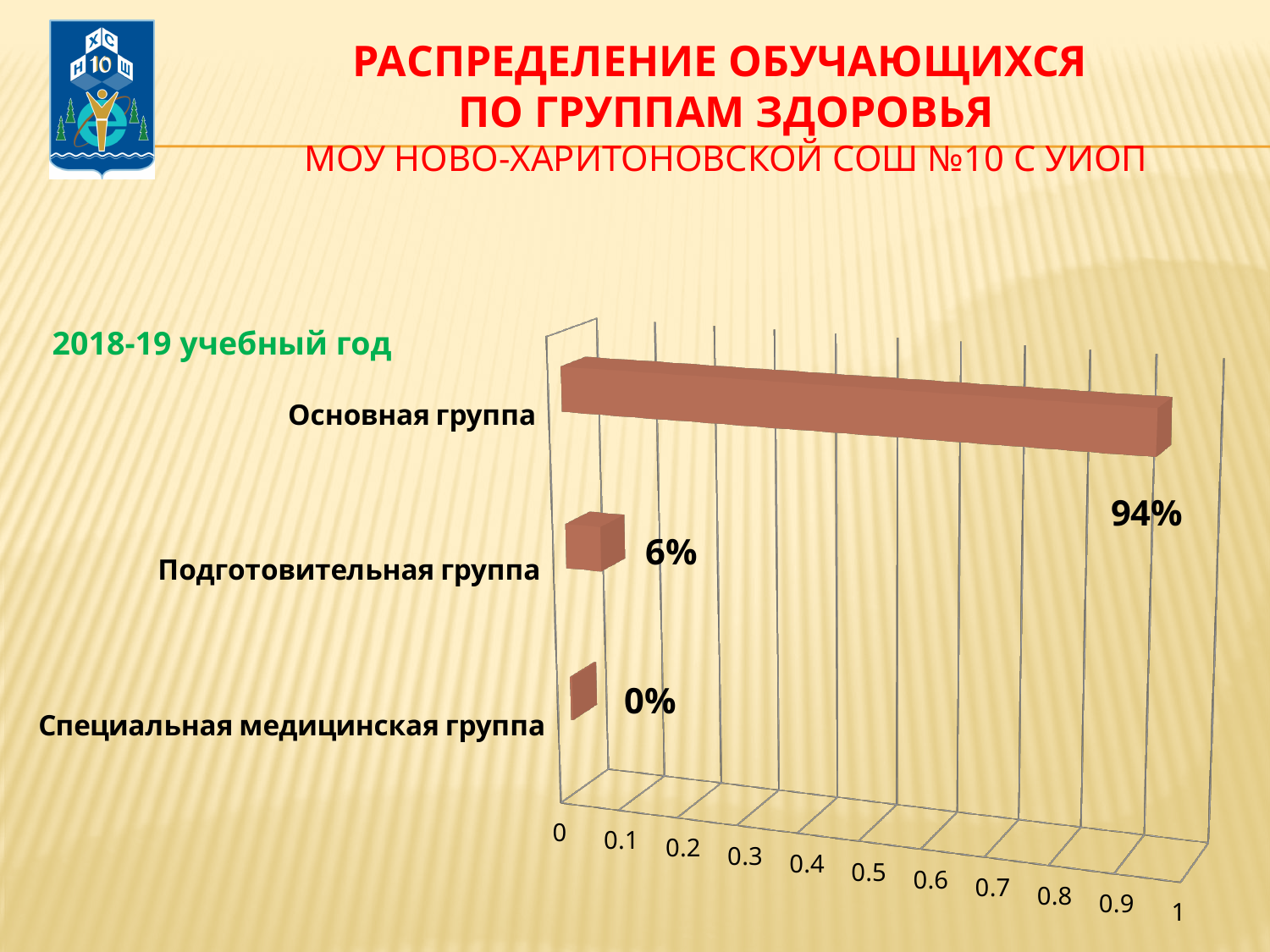
What is the value for Подготовительная группа? 6% Is the value for Основная группа greater or less than 0.5? greater What is the maximum value shown on the horizontal axis? 1 What is the difference between the values for Основная группа and Подготовительная группа? 88% How many groups are shown in the chart? 3 Which is larger, the value for Подготовительная группа or the value for Специальная медицинская группа? Подготовительная группа What is the value for Основная группа? 94% What kind of chart is shown on the slide? bar chart What is the value for Специальная медицинская группа? 0% Which group has the lowest value? Специальная медицинская группа Which school year does the chart refer to? 2018-19 учебный год Which group has the highest value? Основная группа